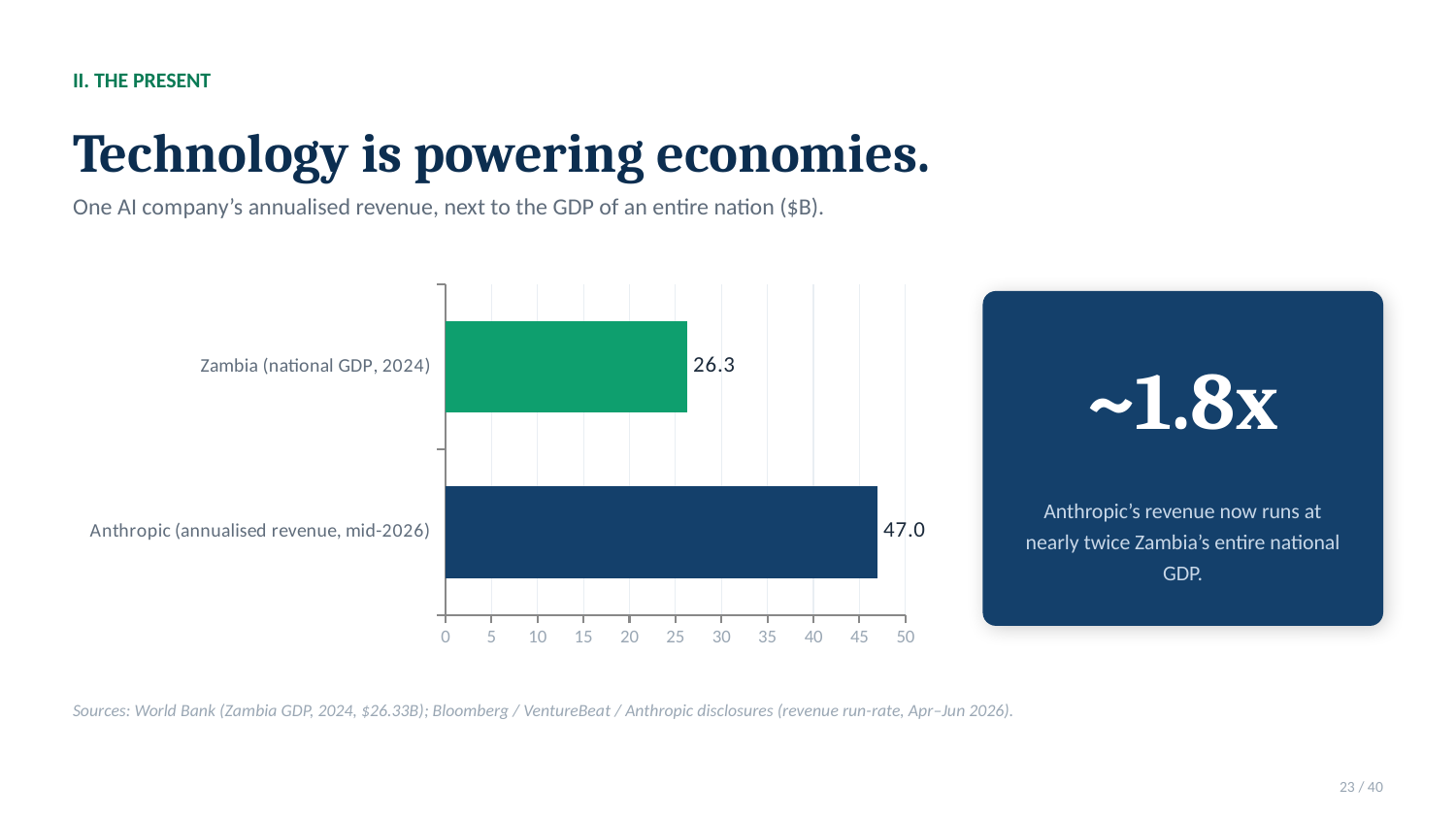
What multiplier is shown in the callout box to the right of the chart? ~1.8x What is the difference between the Anthropic value and the Zambia value? 20.7 Is the value for Zambia (national GDP, 2024) greater or less than 30? less What is the value shown for Anthropic (annualised revenue, mid-2026)? 47.0 Which is larger, the value for Zambia or the value for Anthropic? Anthropic What is the value shown for Zambia (national GDP, 2024)? 26.3 What is the maximum value shown on the x axis? 50 Which category has the lowest value? Zambia (national GDP, 2024) How many categories are plotted in the chart? 2 Is the value for Anthropic (annualised revenue, mid-2026) greater or less than 45? greater What kind of chart is shown on the slide? Bar chart Which category has the highest value? Anthropic (annualised revenue, mid-2026)